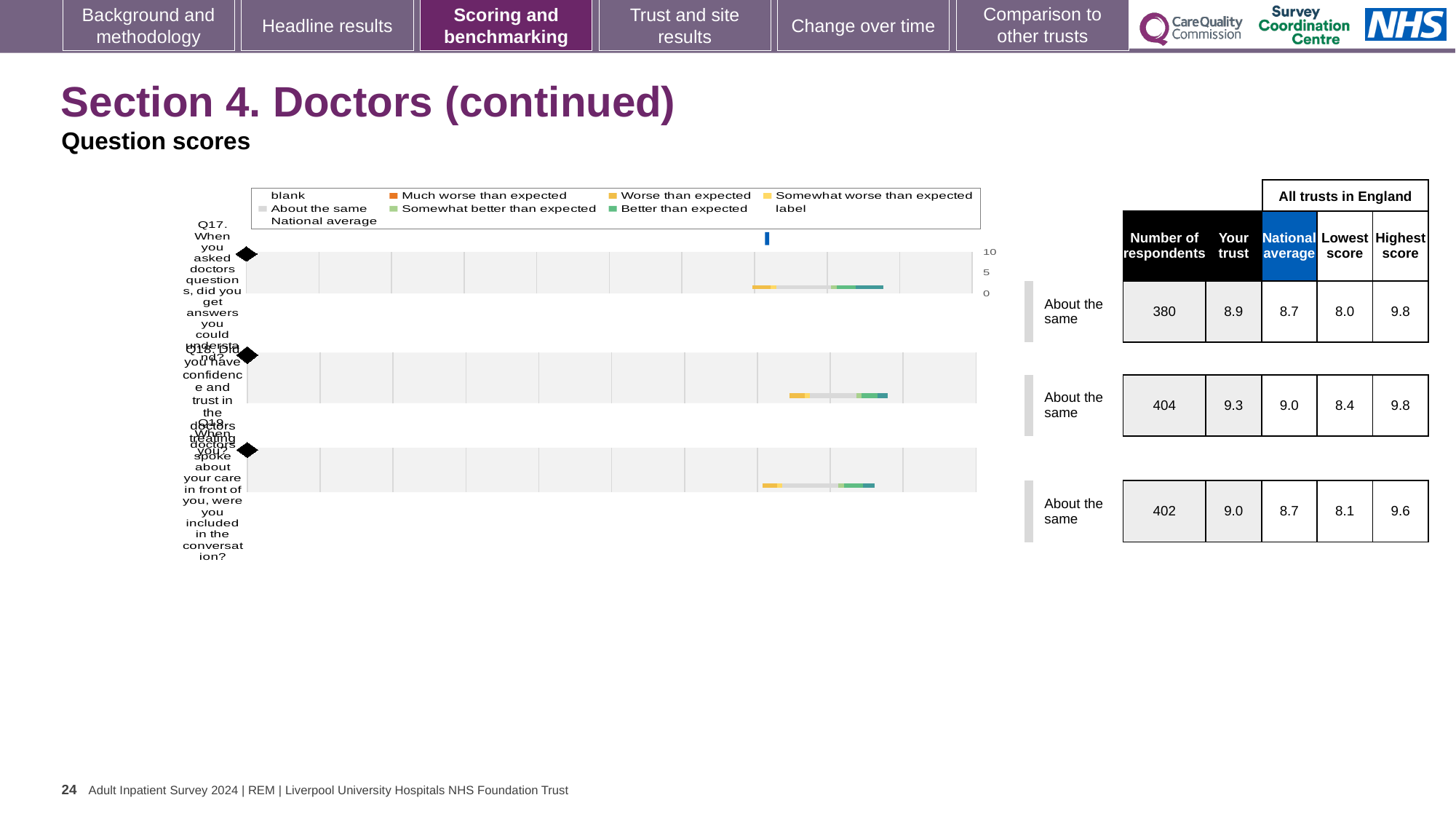
Which question has the highest 'Your trust' score? Q18 How many questions (Q17, Q18, Q19) are charted on the slide? 3 For Q17 (When you asked doctors questions, did you get answers you could understand?), what is the number of respondents? 380 What benchmark category is shown for Q19? About the same For Q18 (Did you have confidence and trust in the doctors treating you?), what is the national average score? 9.0 For Q17, which is larger: the 'Your trust' score or the national average? Your trust Which question has the lowest 'Lowest score' value? Q17 For Q18, what is the difference between the 'Your trust' score and the national average? 0.3 What is the highest value shown on the score axis of the charts? 10 What kind of chart is used to show the question scores on the slide? bar chart For Q17, what is the 'Your trust' score? 8.9 For Q19 (When doctors spoke about your care in front of you, were you included in the conversation?), what is the highest score among all trusts in England? 9.6